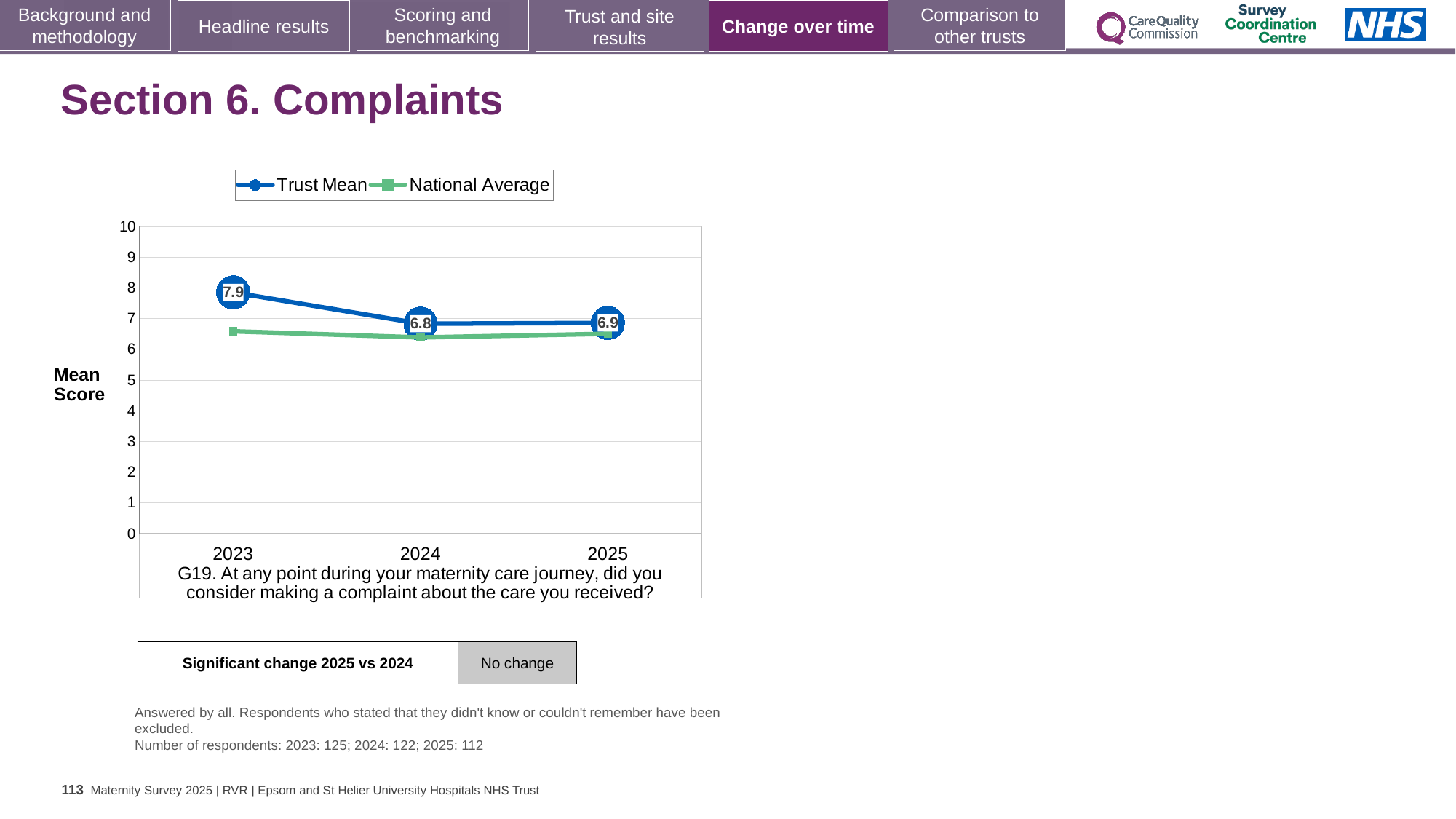
What kind of chart is shown on the slide? line chart In which year is the Trust Mean score lowest? 2024 What is the Trust Mean score for 2025? 6.9 In 2023, which is higher: the Trust Mean or the National Average? Trust Mean Is the National Average value for 2023 greater or less than 7? less How many years are shown on the x axis of the chart? 3 Does the Trust Mean score rise or fall from 2023 to 2024? fall How many series does the chart legend list? 2 What is the Trust Mean score for 2024? 6.8 What is the difference between the Trust Mean score in 2023 and in 2024? 1.1 In which year is the Trust Mean score highest? 2023 What is the Trust Mean score for 2023? 7.9